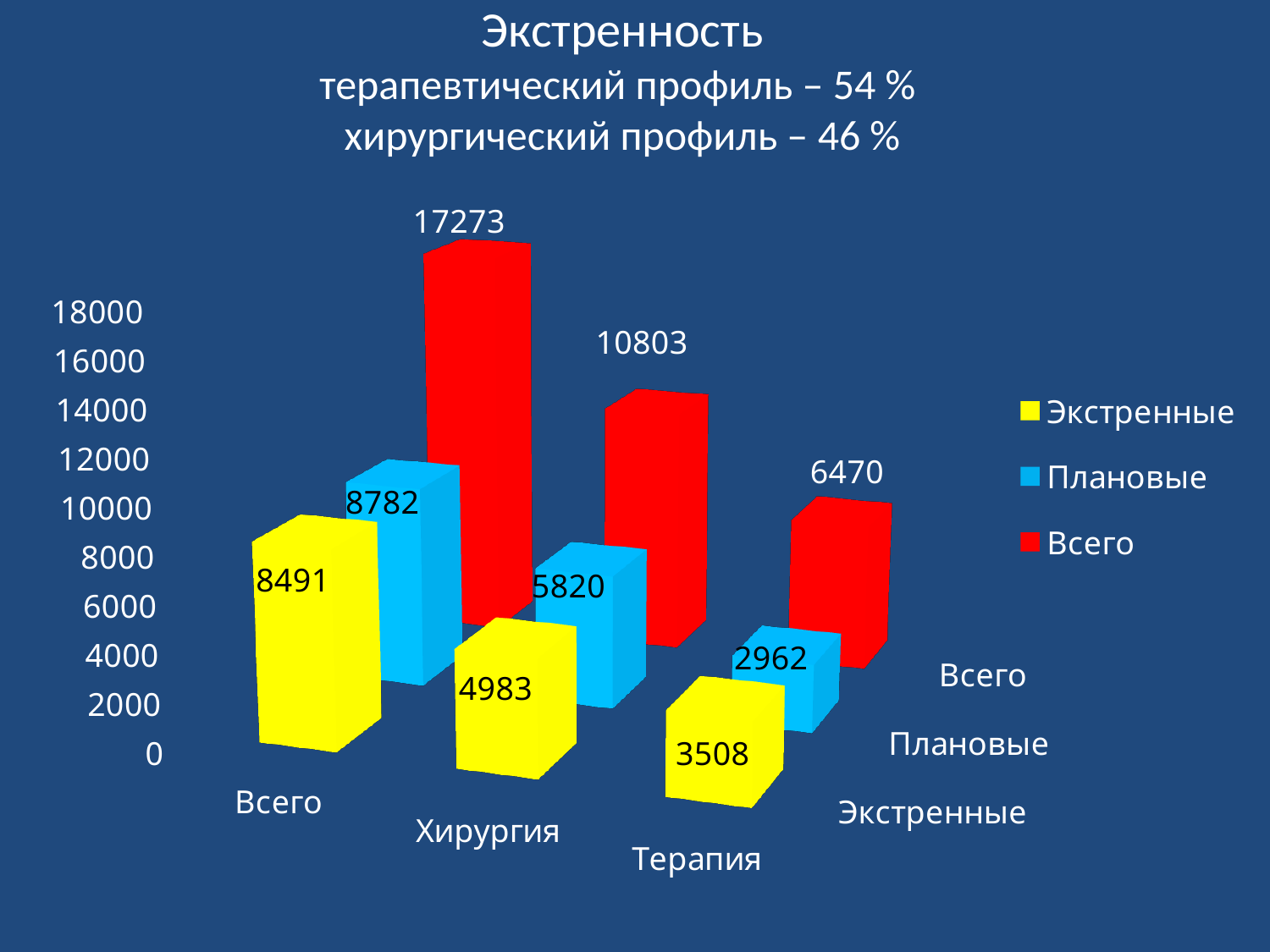
What is the value of Экстренные for Всего? 8491 How many series does the legend list? 3 How many categories are shown on the x axis? 3 Which is larger for Терапия: Экстренные or Плановые? Экстренные Which category has the lowest value in the Экстренные series? Терапия What is the difference between Плановые and Экстренные for Хирургия? 837 Which category has the highest value in the Всего series? Всего What is the value of Всего for Терапия? 6470 What colour represents the Плановые series? blue What kind of chart is shown on the slide? bar chart What is the value of Плановые for Хирургия? 5820 What is the value of Плановые for Терапия? 2962